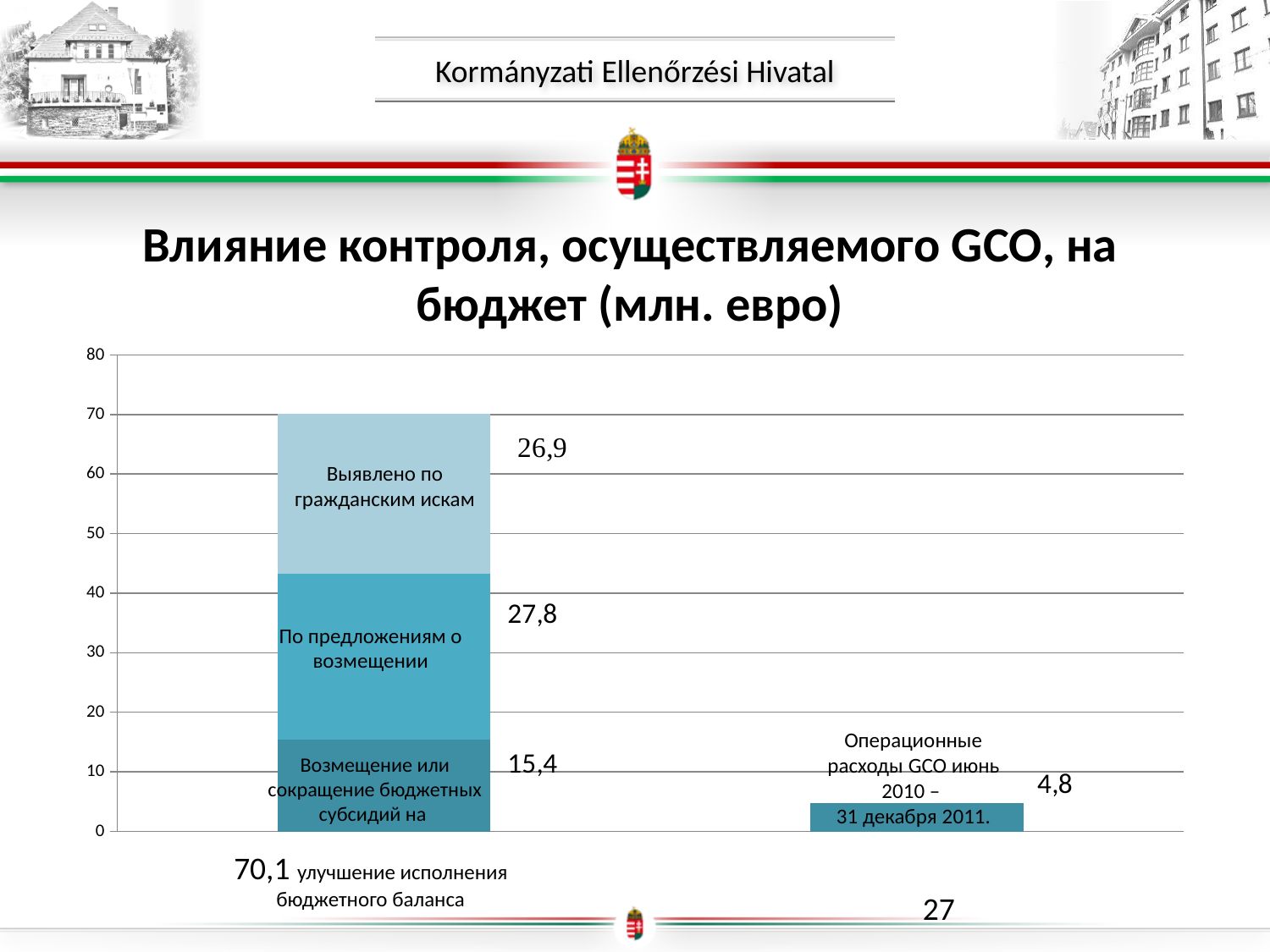
What is the value shown for "Операционные расходы GCO июнь 2010 – 31 декабря 2011."? 4,8 What is the total of the stacked bar on the left (улучшение исполнения бюджетного баланса)? 70,1 Which is larger: the total of the left stacked bar (70,1) or the value for "Операционные расходы GCO" (4,8)? the left stacked bar (70,1) What is the difference between the "По предложениям о возмещении" segment (27,8) and the "Возмещение или сокращение бюджетных субсидий на" segment (15,4)? 12,4 What is the value of the segment labelled "Возмещение или сокращение бюджетных субсидий на"? 15,4 Is the value for "Операционные расходы GCO июнь 2010 – 31 декабря 2011." greater or less than 10? less Which segment of the left stacked bar has the largest value? По предложениям о возмещении Which segment of the left stacked bar has the smallest value? Возмещение или сокращение бюджетных субсидий на What is the value of the segment labelled "По предложениям о возмещении"? 27,8 What type of chart is shown on the slide? bar chart What is the title of the chart on the slide? Влияние контроля, осуществляемого GCO, на бюджет (млн. евро) What is the value of the segment labelled "Выявлено по гражданским искам"? 26,9